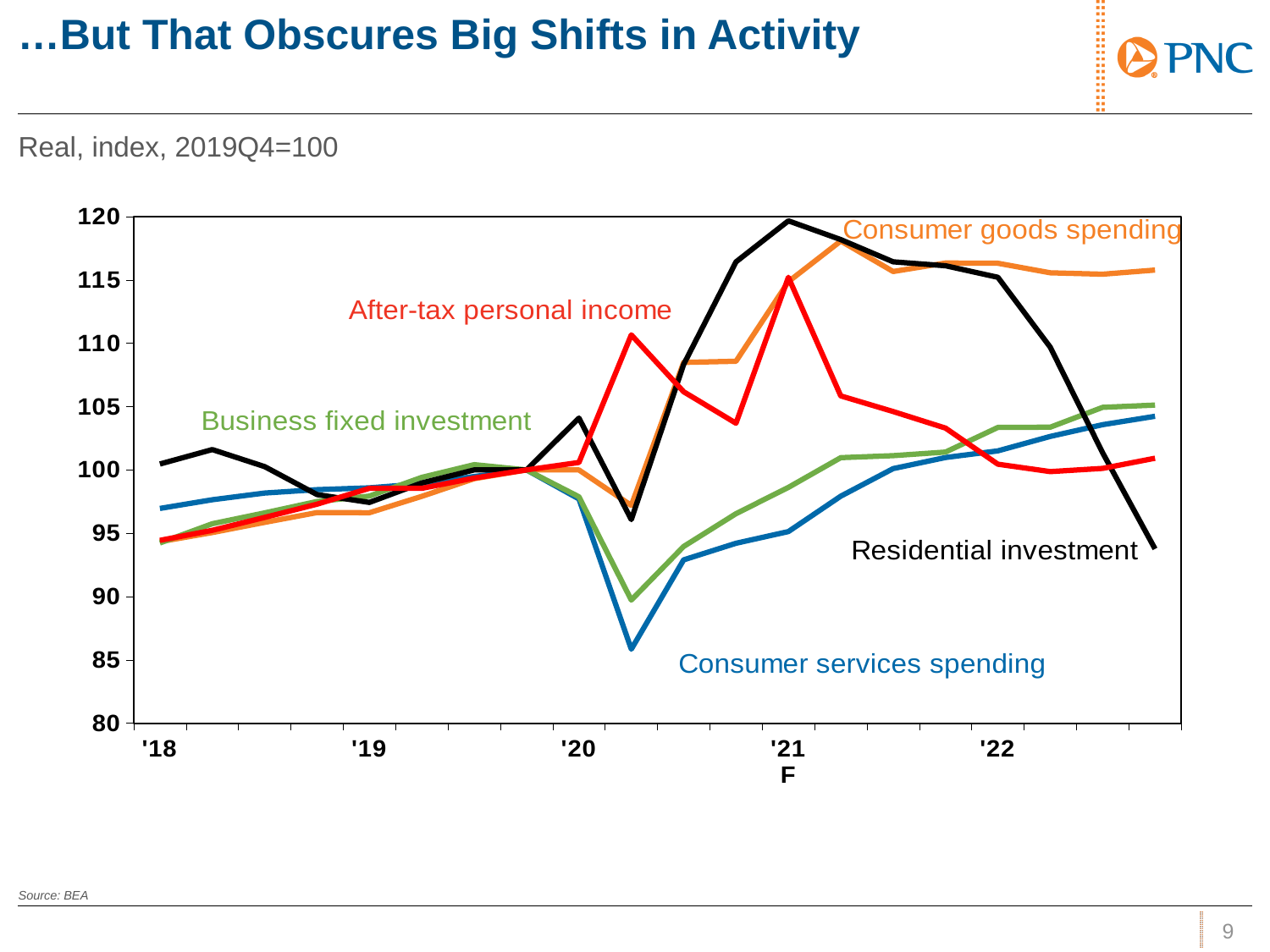
What type of chart is shown on the slide? Line chart Is the lowest value of Consumer services spending in 2020 greater or less than 90? less At the 2020 trough, which is higher: Business fixed investment or Consumer services spending? Business fixed investment Is the value of Consumer goods spending at the end of 2022 greater or less than 110? greater Does Residential investment rise or fall from its 2021 peak to the end of 2022? Fall What is the base period of the index shown in the chart subtitle? 2019Q4=100 Is the value of After-tax personal income at the start of 2018 greater or less than 100? less How many data series are labeled on the chart? 5 Which series reaches the highest value on the chart? Residential investment At the end of 2022, which is higher: Residential investment or Consumer goods spending? Consumer goods spending Which series falls to the lowest value on the chart? Consumer services spending